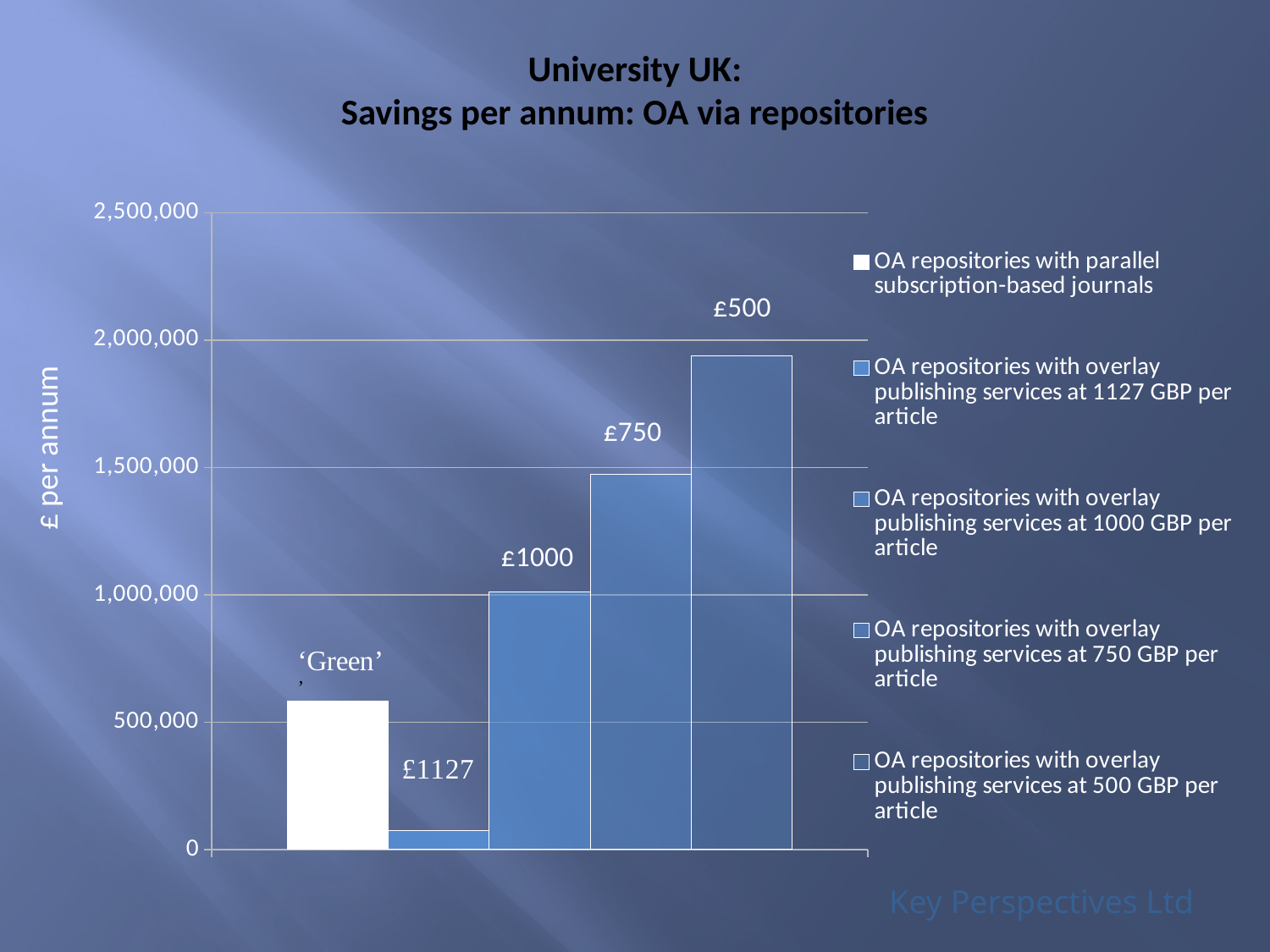
Is the value for the £500 overlay bar greater or less than 1,500,000? greater Is the value for the £1127 overlay bar greater or less than 500,000? less Which bar shows the highest savings per annum? OA repositories with overlay publishing services at 500 GBP per article Which is larger: the savings for the 'Green' bar or the £1127 overlay bar? 'Green' What kind of chart is shown on the slide? bar chart Among the overlay publishing bars, do savings rise or fall as the per-article price decreases from £1127 to £500? rise Which is larger: the savings for the £750 overlay bar or the £1000 overlay bar? £750 What is the label on the vertical axis of the chart? £ per annum Which bar shows the lowest savings per annum? OA repositories with overlay publishing services at 1127 GBP per article Is the value for the £750 overlay bar greater or less than 1,000,000? greater How many series does the legend list? 5